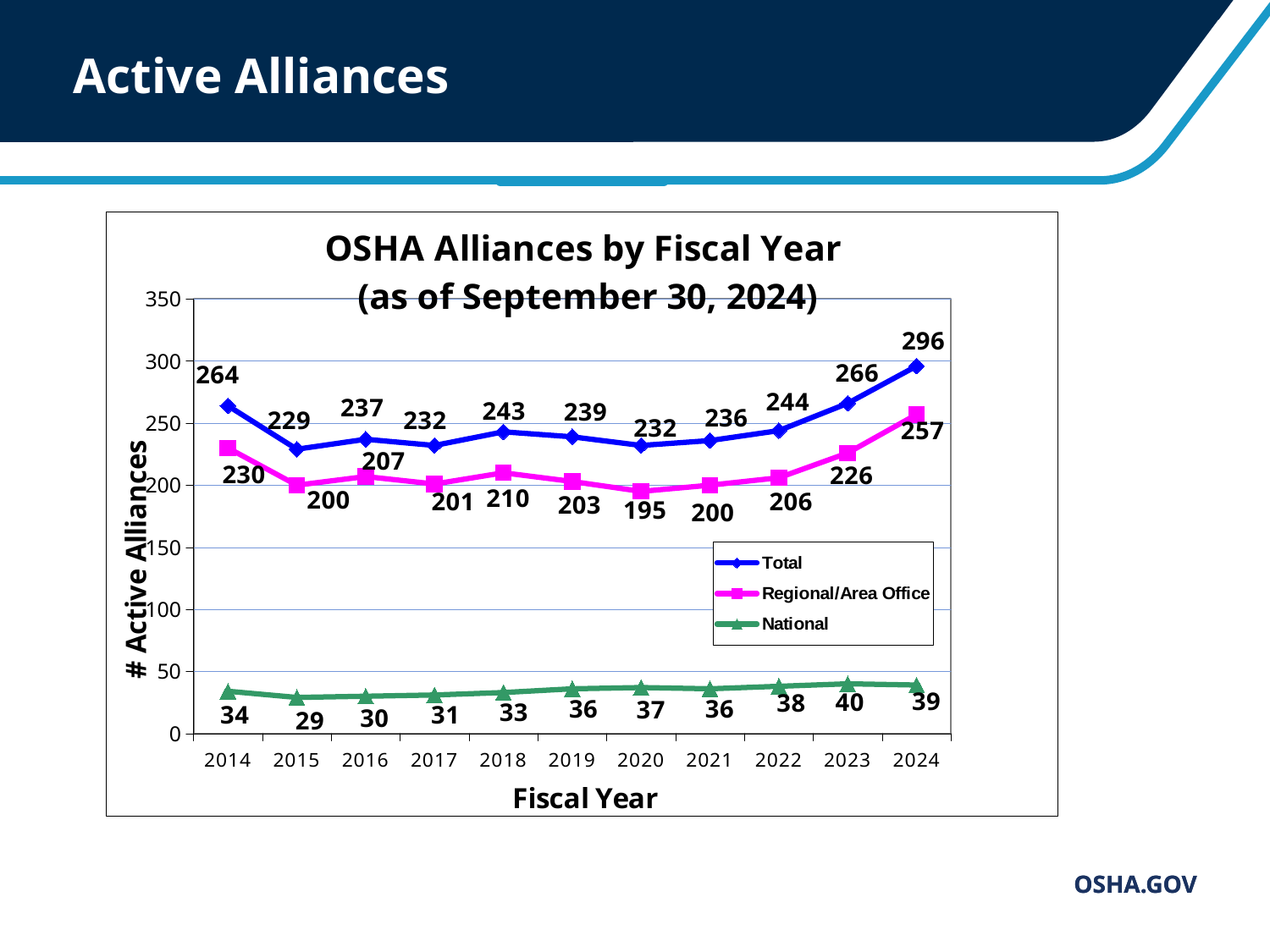
What is the National value for fiscal year 2015? 29 How many series does the legend list? 3 What is the label of the y axis? # Active Alliances Is the Total value for 2019 greater or less than 250? less What is the difference between the Total values for 2024 and 2023? 30 In which fiscal year is the Regional/Area Office series lowest? 2020 In which fiscal year is the Total series highest? 2024 What is the Regional/Area Office value for fiscal year 2020? 195 Which is larger, the Regional/Area Office value in 2014 or in 2023? 2014 What is the Total number of active alliances in fiscal year 2024? 296 What kind of chart is shown on the slide? line chart How many fiscal years are shown on the x axis? 11